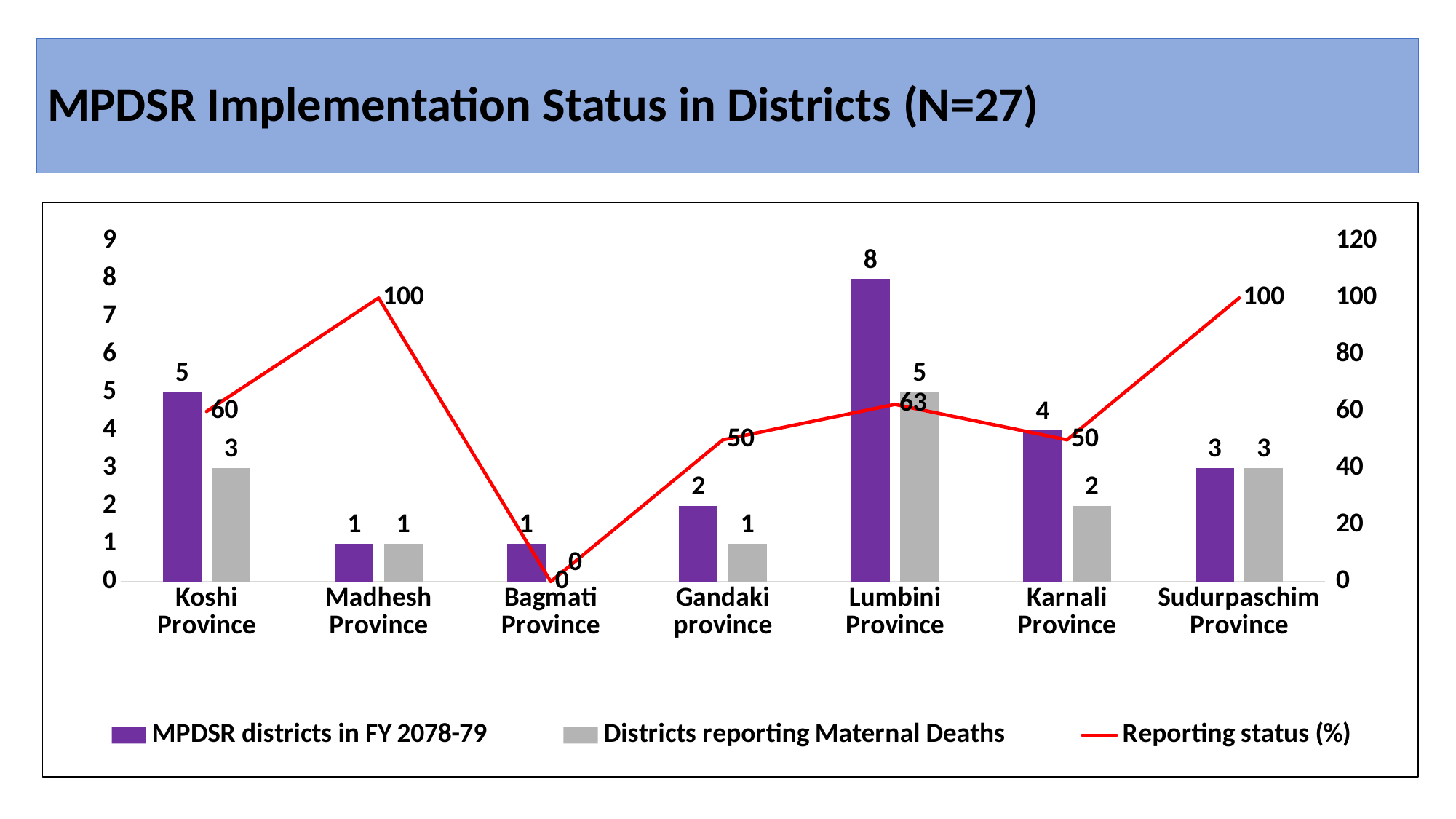
Which is larger: the number of MPDSR districts in FY 2078-79 in Koshi Province or in Sudurpaschim Province? Koshi Province What kind of chart is shown on the slide? Combined bar and line chart What is the reporting status (%) for Gandaki province? 50 What is the title of the chart? MPDSR Implementation Status in Districts (N=27) How many series does the legend list? 3 What is the difference between the number of MPDSR districts in FY 2078-79 and the number of districts reporting maternal deaths in Karnali Province? 2 Which province has the highest number of MPDSR districts in FY 2078-79? Lumbini Province Which province has the lowest reporting status (%)? Bagmati Province How many provinces are shown on the x axis? 7 How many MPDSR districts in FY 2078-79 are shown for Lumbini Province? 8 How many districts reporting maternal deaths are shown for Koshi Province? 3 What is the reporting status (%) for Lumbini Province? 63